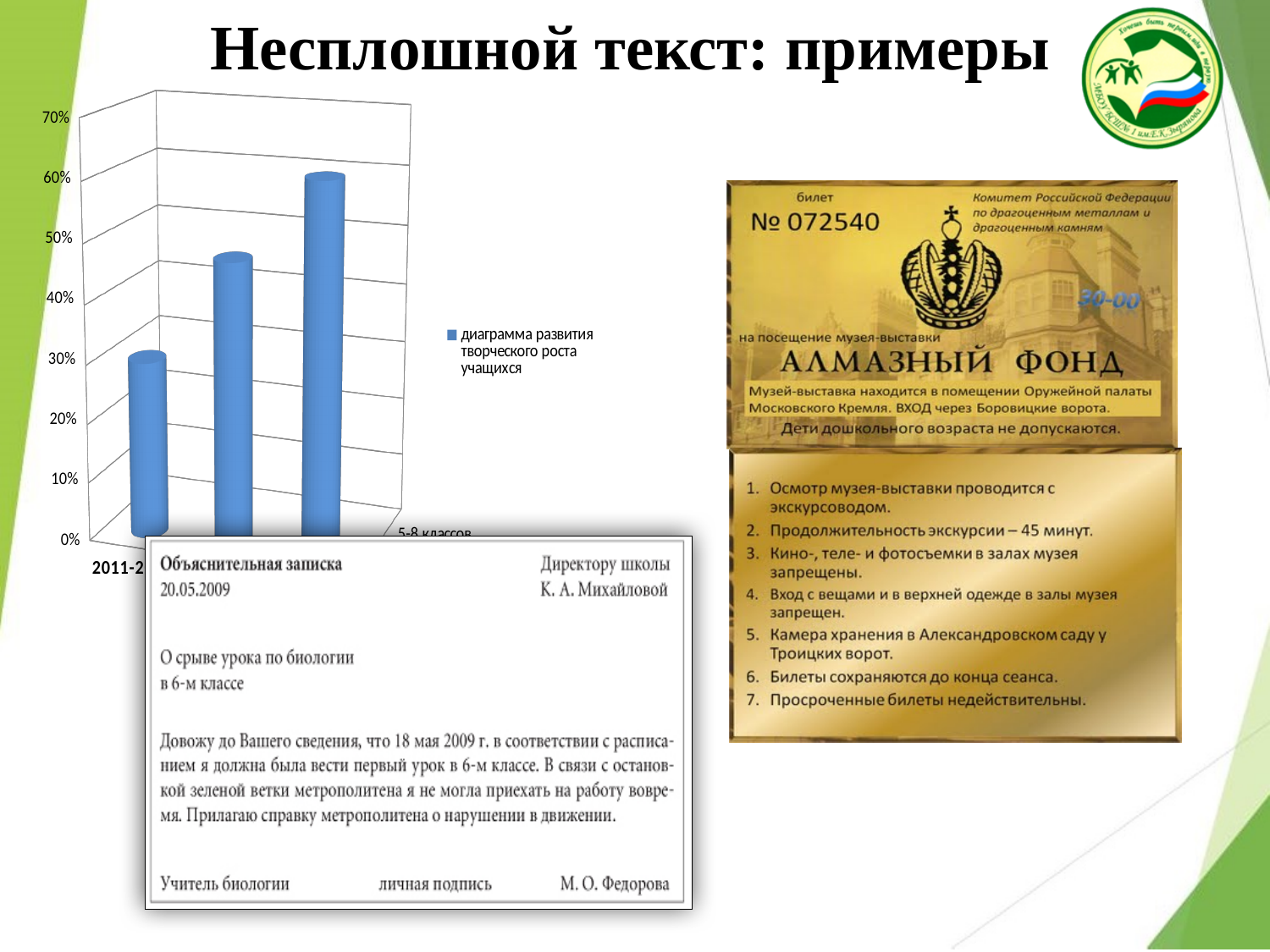
How many series does the legend of the chart list? 1 What kind of chart is shown on the left of the slide? bar chart Which bar is the tallest in the chart: the first, second or third from the left? third Is the value of the leftmost bar greater or less than 40%? less What is the legend entry of the chart? диаграмма развития творческого роста учащихся Is the value of the middle bar greater or less than 60%? less Which bar is the shortest in the chart: the first, second or third from the left? first Which is larger: the value of the first bar or the value of the third bar? the third bar How many bars does the chart on the left of the slide show? 3 Is the value of the rightmost bar greater or less than 50%? greater Do the bar values rise or fall from left to right across the chart? rise What colour are the bars in the chart? blue